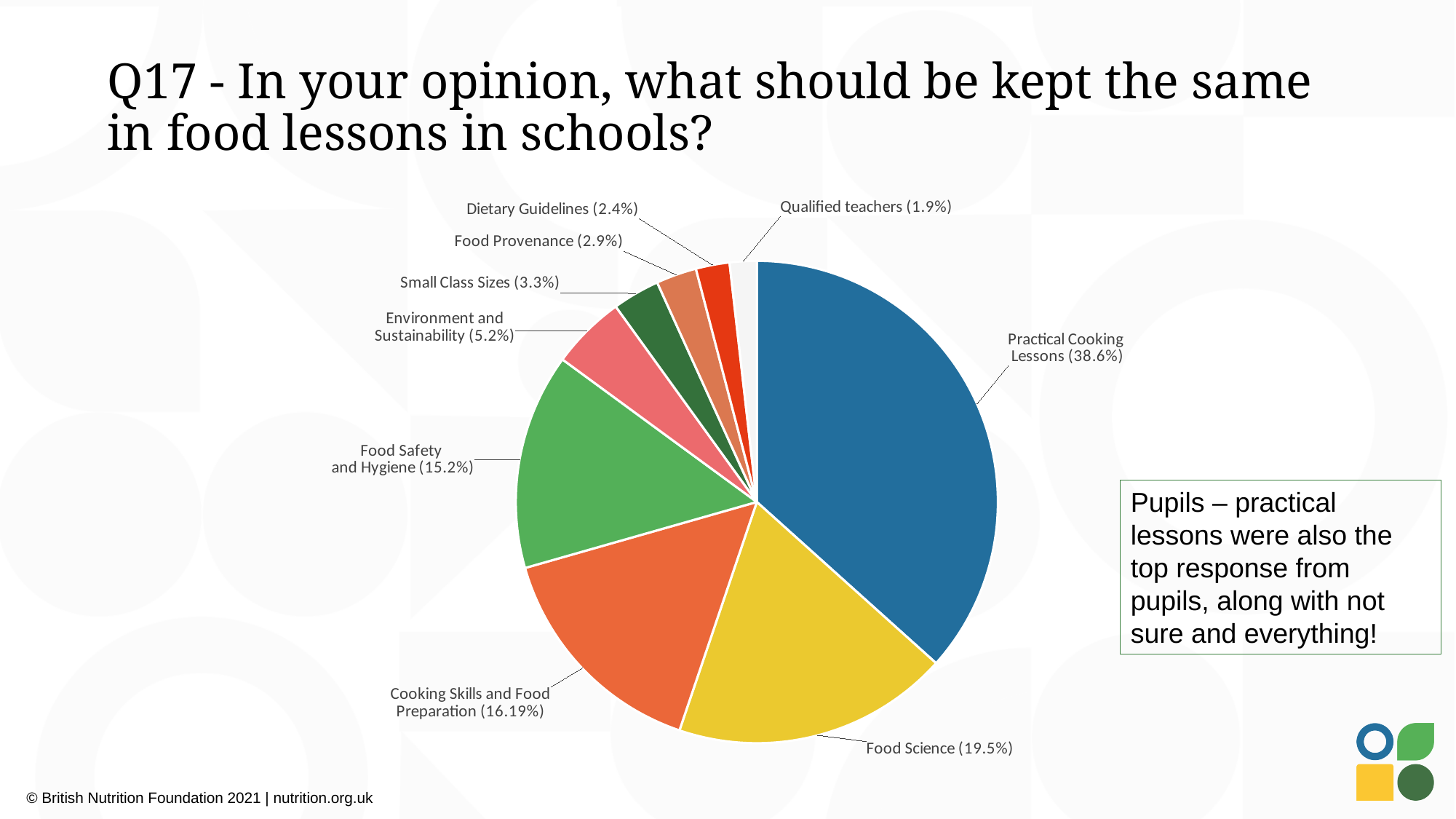
What percentage is shown for Qualified teachers? 1.9% What percentage is shown for Food Safety and Hygiene? 15.2% What percentage is shown for Cooking Skills and Food Preparation? 16.19% What share of responses is Practical Cooking Lessons? 38.6% Which labelled category has the smallest share of the pie? Qualified teachers Which is larger, Small Class Sizes or Food Provenance? Small Class Sizes What colour is the Food Science slice? Yellow What type of chart is shown on the slide? Pie chart Which labelled category has the largest share of the pie? Practical Cooking Lessons What percentage is shown for Food Science? 19.5% What percentage is shown for Environment and Sustainability? 5.2% What is the difference in percentage points between Practical Cooking Lessons and Food Science? 19.1